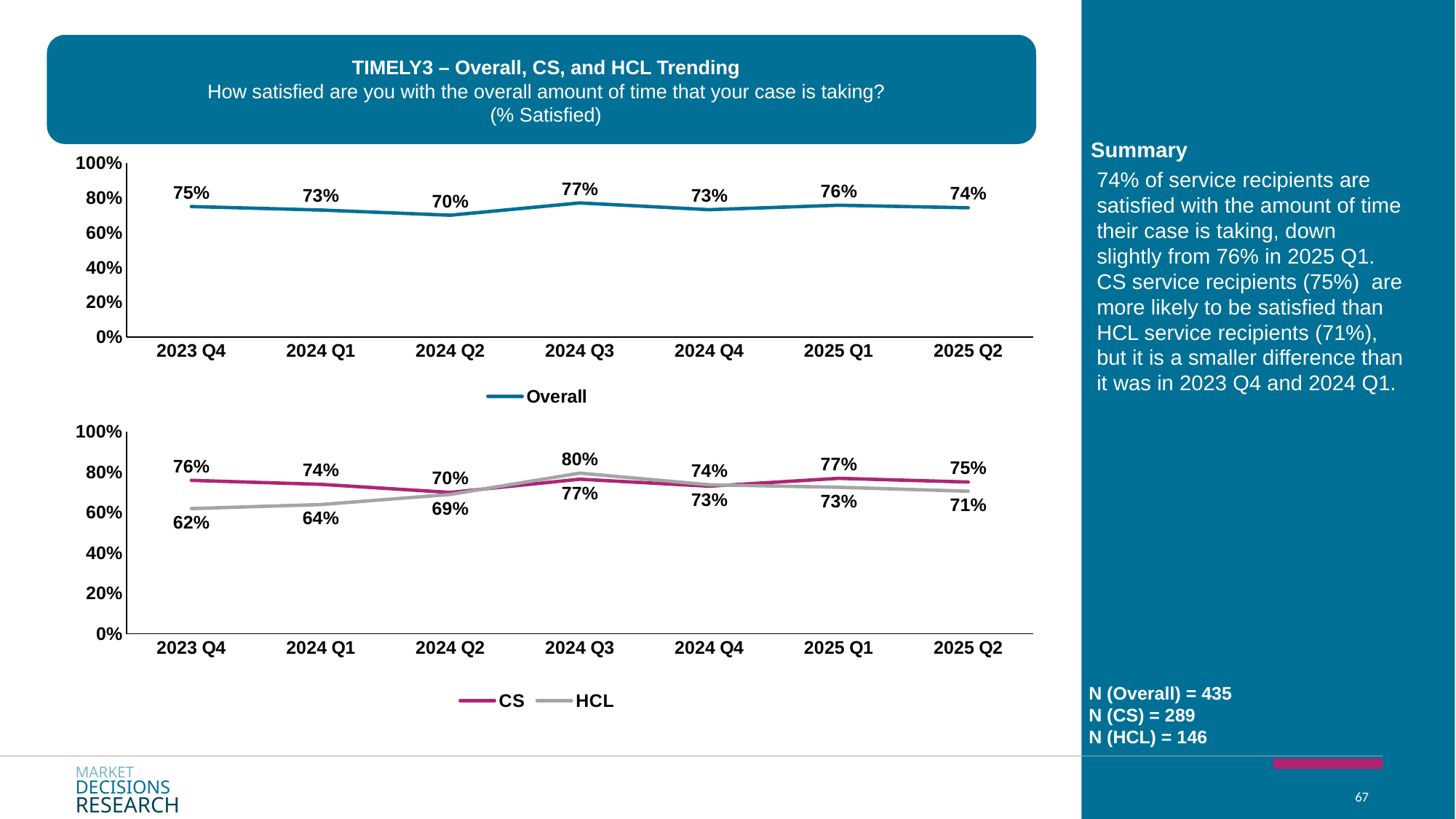
In the top chart (Overall), how many quarters are plotted? 7 What kind of chart is the top chart (Overall)? Line chart In the bottom chart (CS and HCL), what is the CS value for 2025 Q1? 77% In the bottom chart (CS and HCL), does the HCL line rise or fall from 2023 Q4 to 2024 Q3? Rise In the bottom chart (CS and HCL), which is larger in 2024 Q3, CS or HCL? HCL In the top chart (Overall), which quarter has the lowest value? 2024 Q2 In the bottom chart (CS and HCL), what is the HCL value for 2023 Q4? 62% In the bottom chart (CS and HCL), how many series does the legend list? 2 In the bottom chart (CS and HCL), what is the difference between CS and HCL in 2023 Q4? 14% In the bottom chart (CS and HCL), in which quarter does HCL reach its highest value? 2024 Q3 In the top chart (Overall), what is the value for 2024 Q3? 77% In the top chart (Overall), what is the difference between 2025 Q1 and 2025 Q2? 2%